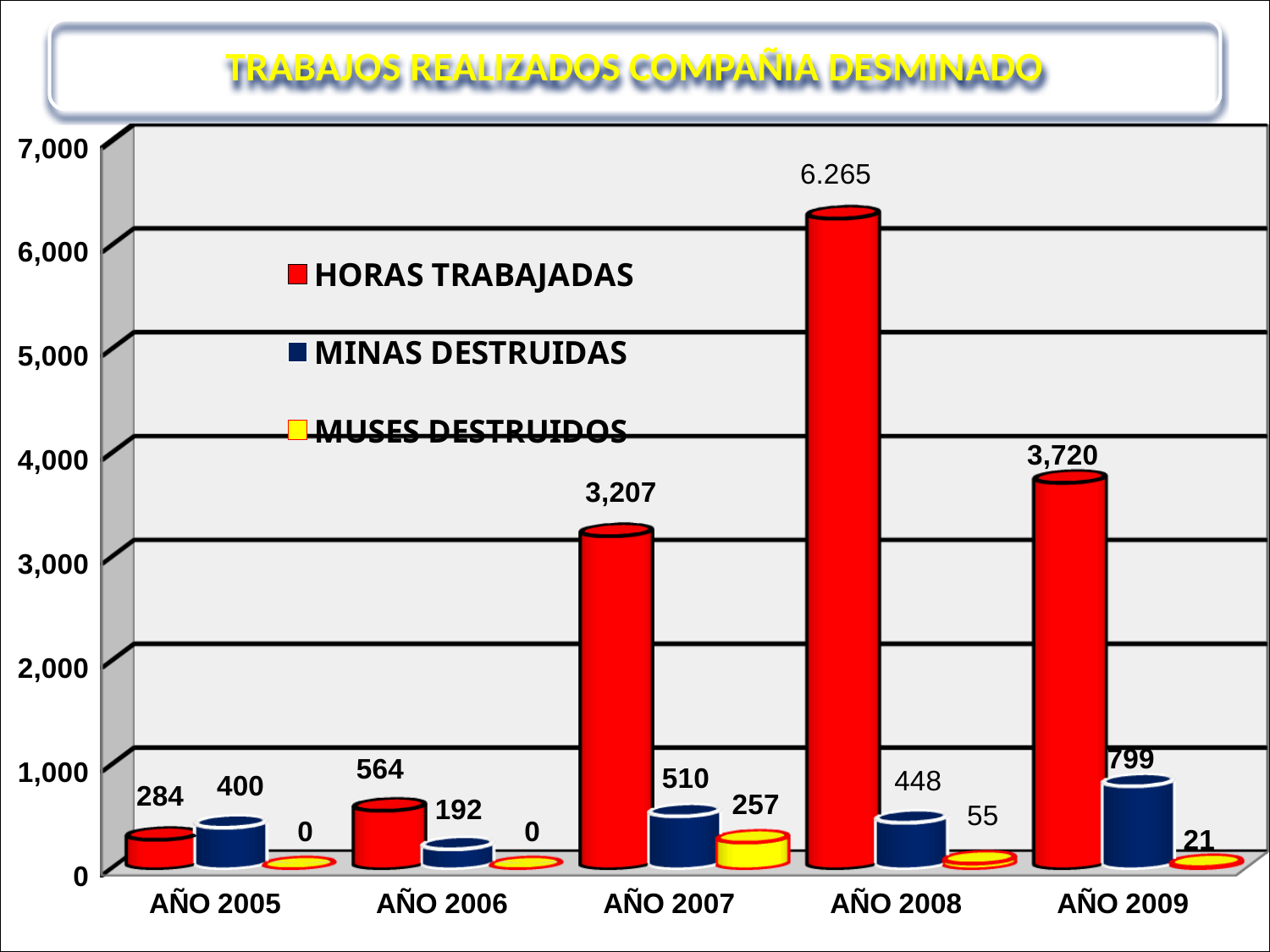
How many years are shown on the x axis? 5 What kind of chart is shown on the slide? bar chart Which year has the highest value for HORAS TRABAJADAS? AÑO 2008 What is the value of MUSES DESTRUIDOS for AÑO 2007? 257 Is the value of HORAS TRABAJADAS for AÑO 2007 greater or less than 3,000? greater What is the value of HORAS TRABAJADAS for AÑO 2006? 564 How many series does the legend list? 3 Which is larger: MINAS DESTRUIDAS in AÑO 2005 or HORAS TRABAJADAS in AÑO 2005? MINAS DESTRUIDAS in AÑO 2005 What is the value of HORAS TRABAJADAS for AÑO 2008? 6.265 Which year has the lowest value for MINAS DESTRUIDAS? AÑO 2006 What is the difference between HORAS TRABAJADAS in AÑO 2009 and AÑO 2007? 513 What is the value of MINAS DESTRUIDAS for AÑO 2009? 799